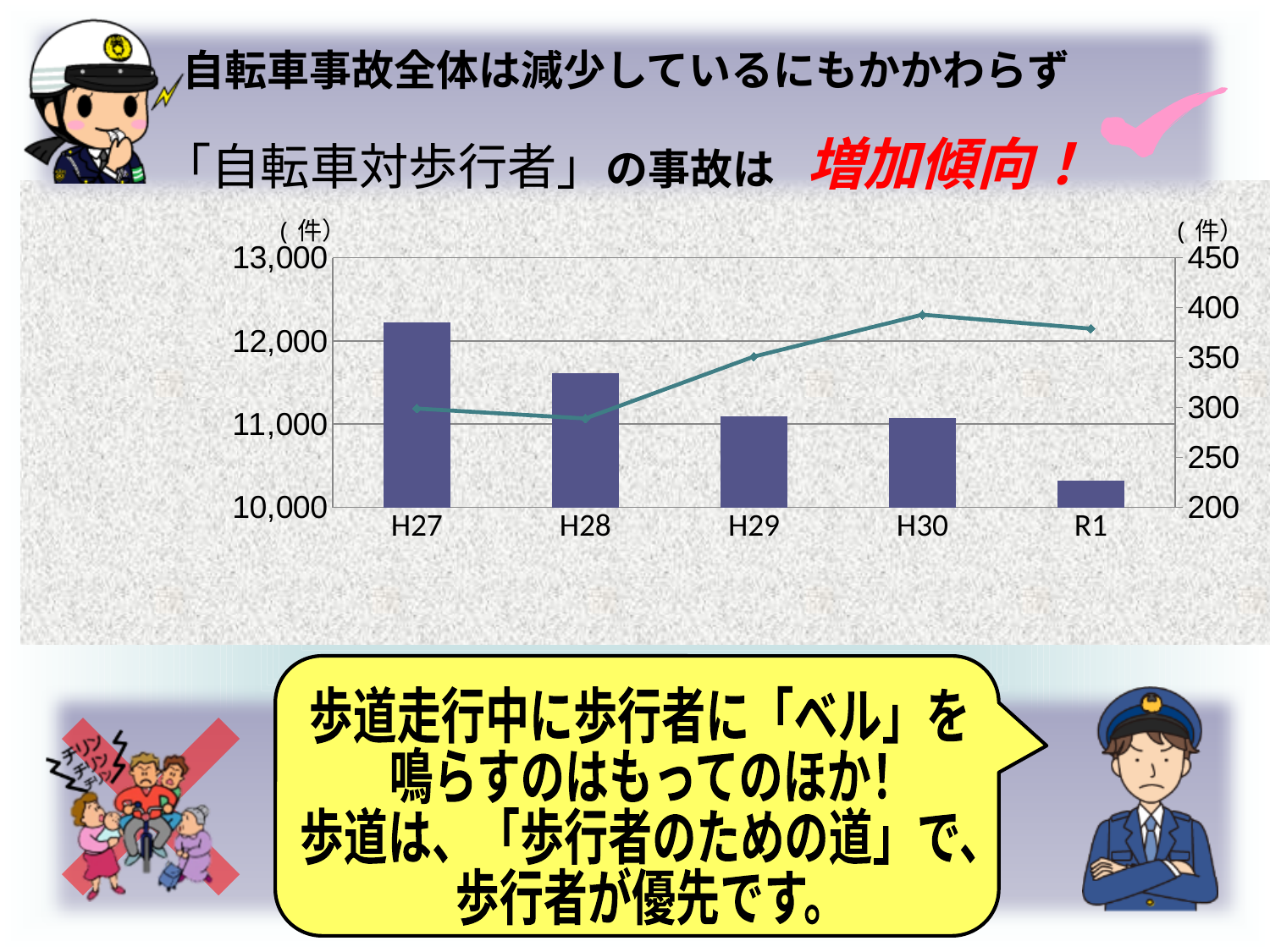
Is the bar value for H27 greater or less than 12,000? greater Does the line series generally rise or fall from H28 to H30? Rise Which category has the shortest bar in the chart? R1 Which bar is taller, H27 or H28? H27 What is the highest value shown on the right-hand axis of the chart? 450 Is the bar value for R1 greater or less than 11,000? less Do the bar values rise or fall from H27 to R1? Fall Is the line value for H30 greater or less than 350? greater How many categories are shown on the x axis of the chart? 5 What kind of chart is shown on the slide? A combined bar and line chart Which category has the tallest bar in the chart? H27